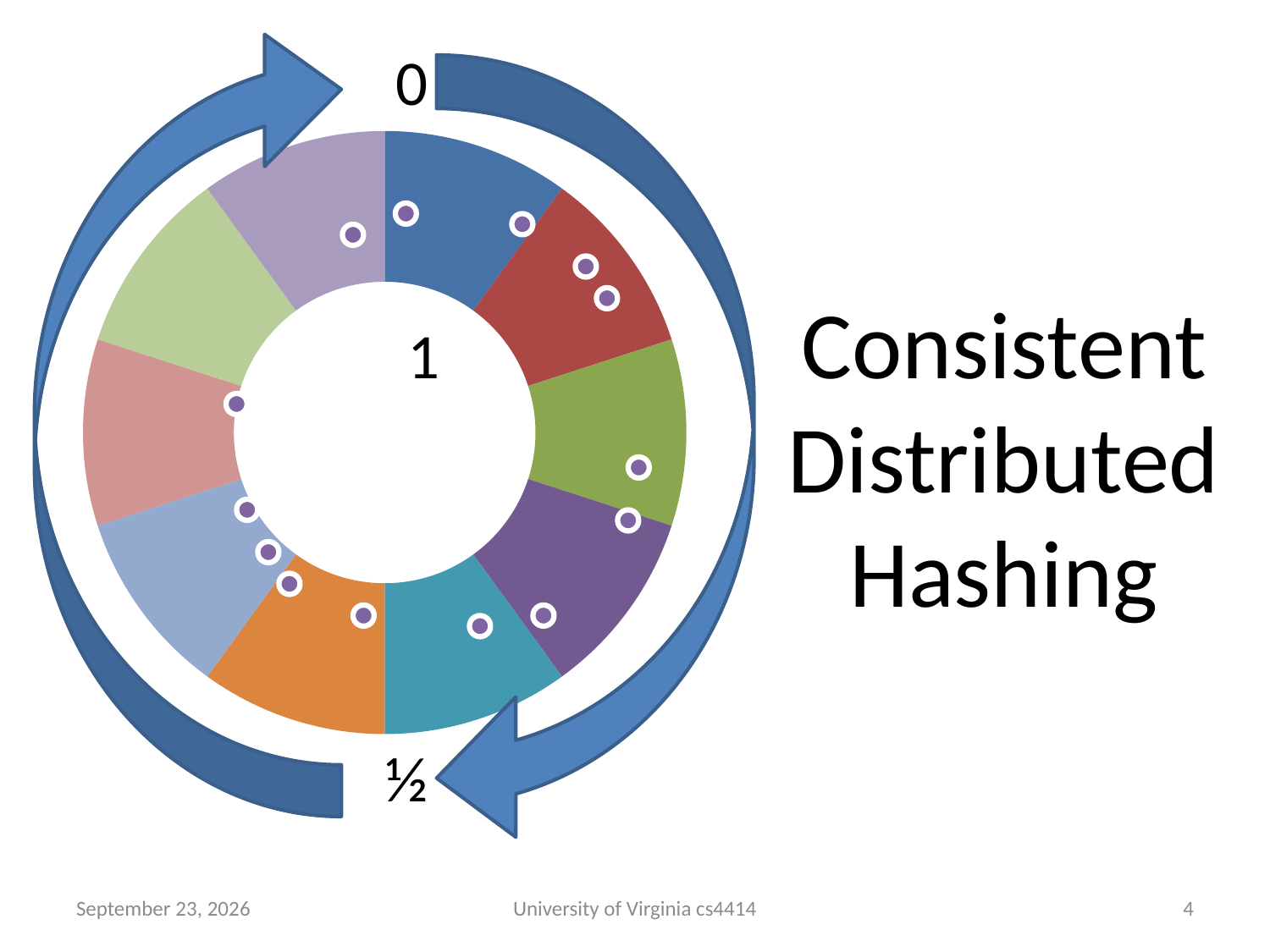
What is the title text shown to the right of the chart? Consistent Distributed Hashing What number is printed in the centre of the doughnut chart? 1 What label is printed at the bottom of the ring? ½ What label is printed at the top of the ring, where the arrow points? 0 How many segments does the doughnut chart have? 10 Does the doughnut chart have a legend? No What kind of chart is shown on the slide? Doughnut chart